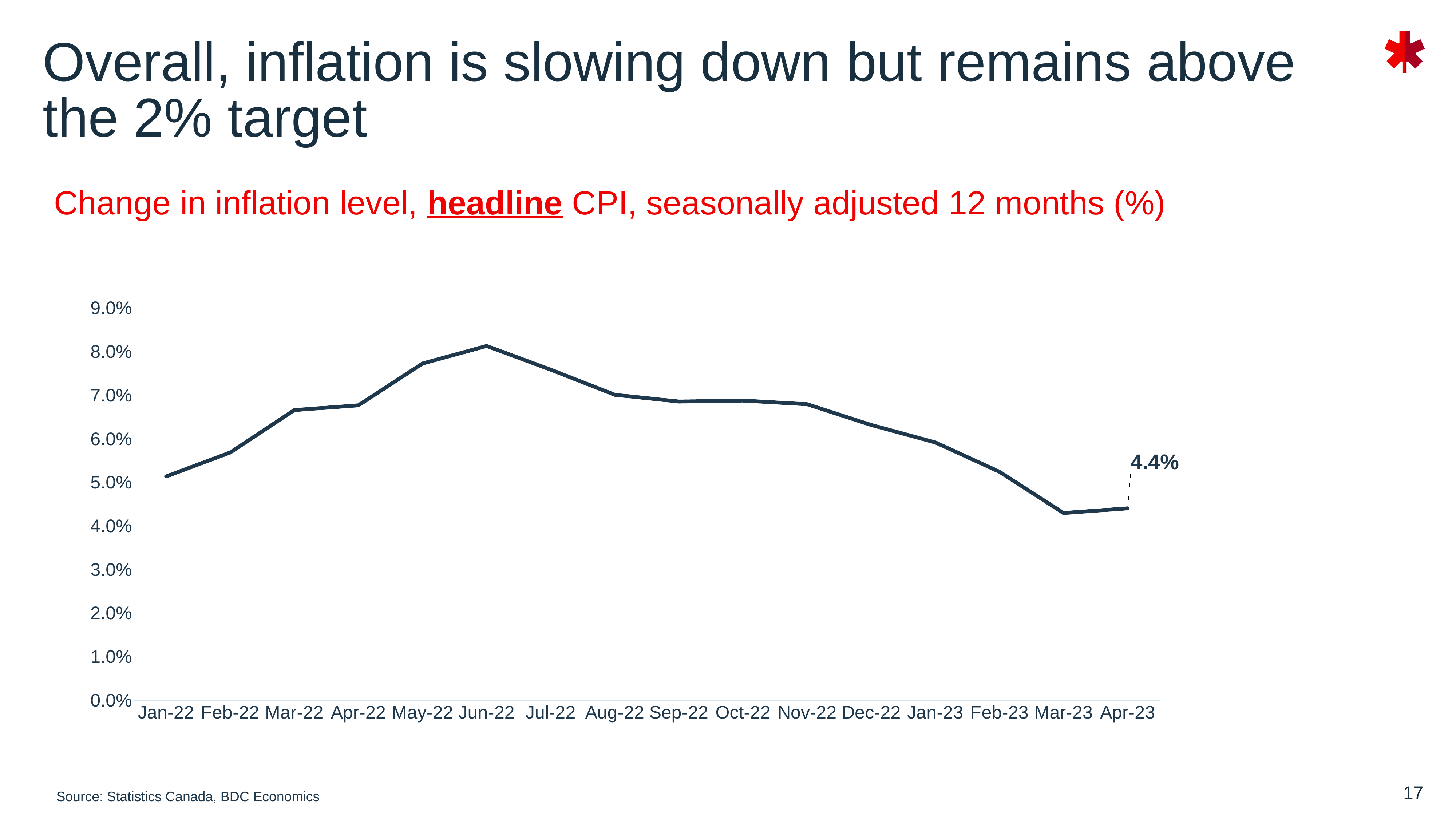
Is the value for Feb-22 greater or less than 6.0%? less What kind of chart is shown on the slide? line chart Do the values rise or fall from Jun-22 to Apr-23? fall What is the title of the chart? Change in inflation level, headline CPI, seasonally adjusted 12 months (%) Which is larger, the value for Jun-22 or the value for Apr-23? Jun-22 Is the value for Mar-22 greater or less than 6.0%? greater Is the value for Jan-23 greater or less than 5.0%? greater Which is larger, the value for Jan-22 or the value for Jan-23? Jan-23 How many months are plotted on the x axis? 16 What is the value for Apr-23? 4.4% Which month has the highest value on the chart? Jun-22